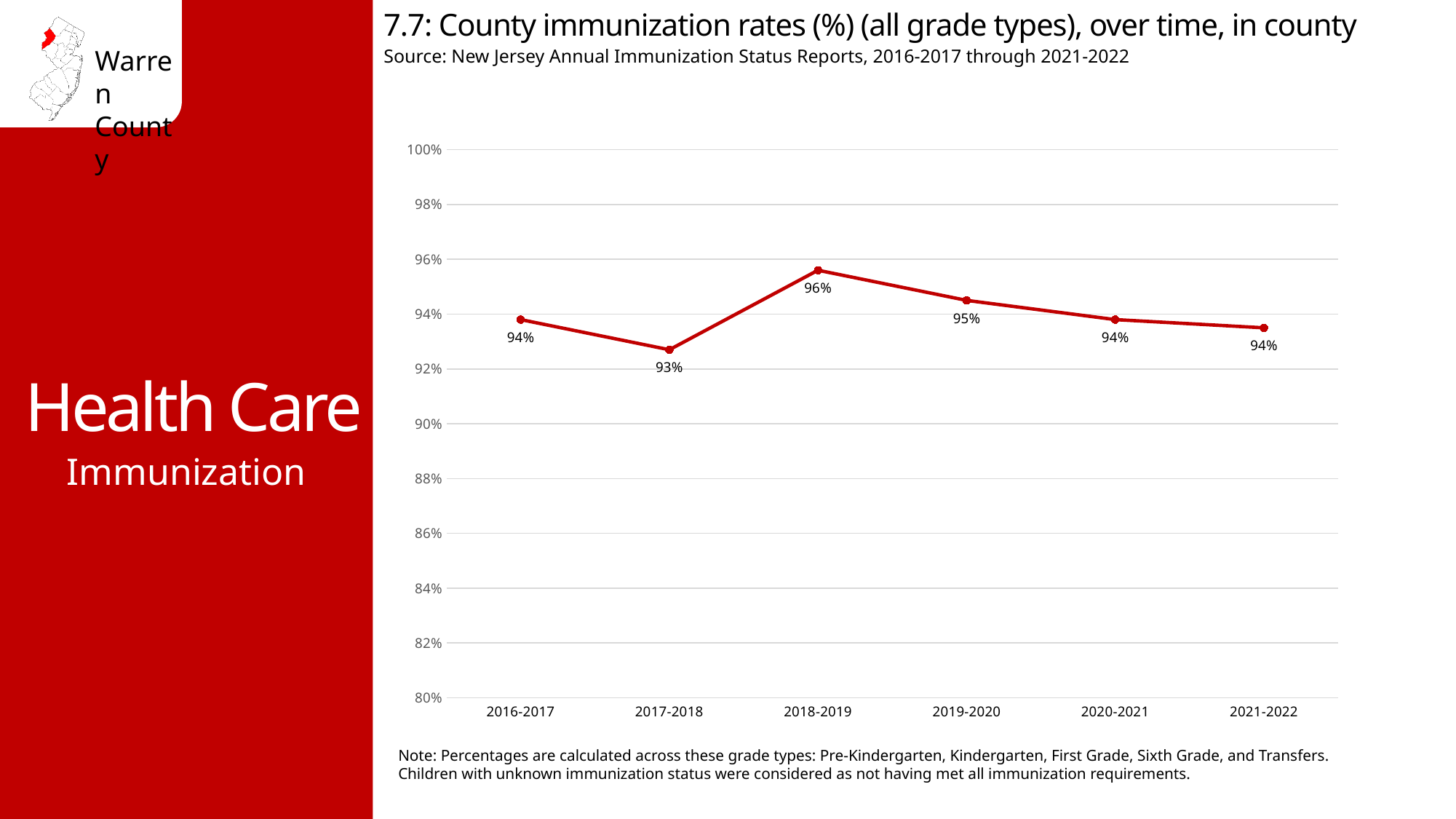
Which is larger, the immunization rate for 2018-2019 or for 2017-2018? 2018-2019 What kind of chart is shown on the slide? Line chart Which school year has the highest immunization rate? 2018-2019 What is the county immunization rate for 2018-2019? 96% How many school years are plotted on the chart? 6 What is the difference in percentage points between the 2018-2019 rate and the 2017-2018 rate? 3 percentage points Do the immunization rates rise or fall from 2018-2019 to 2021-2022? Fall What is the county immunization rate for 2021-2022? 94% Which school year has the lowest immunization rate? 2017-2018 Is the value for 2018-2019 greater or less than 94%? greater What is the county immunization rate for 2017-2018? 93% What is the county immunization rate for 2019-2020? 95%